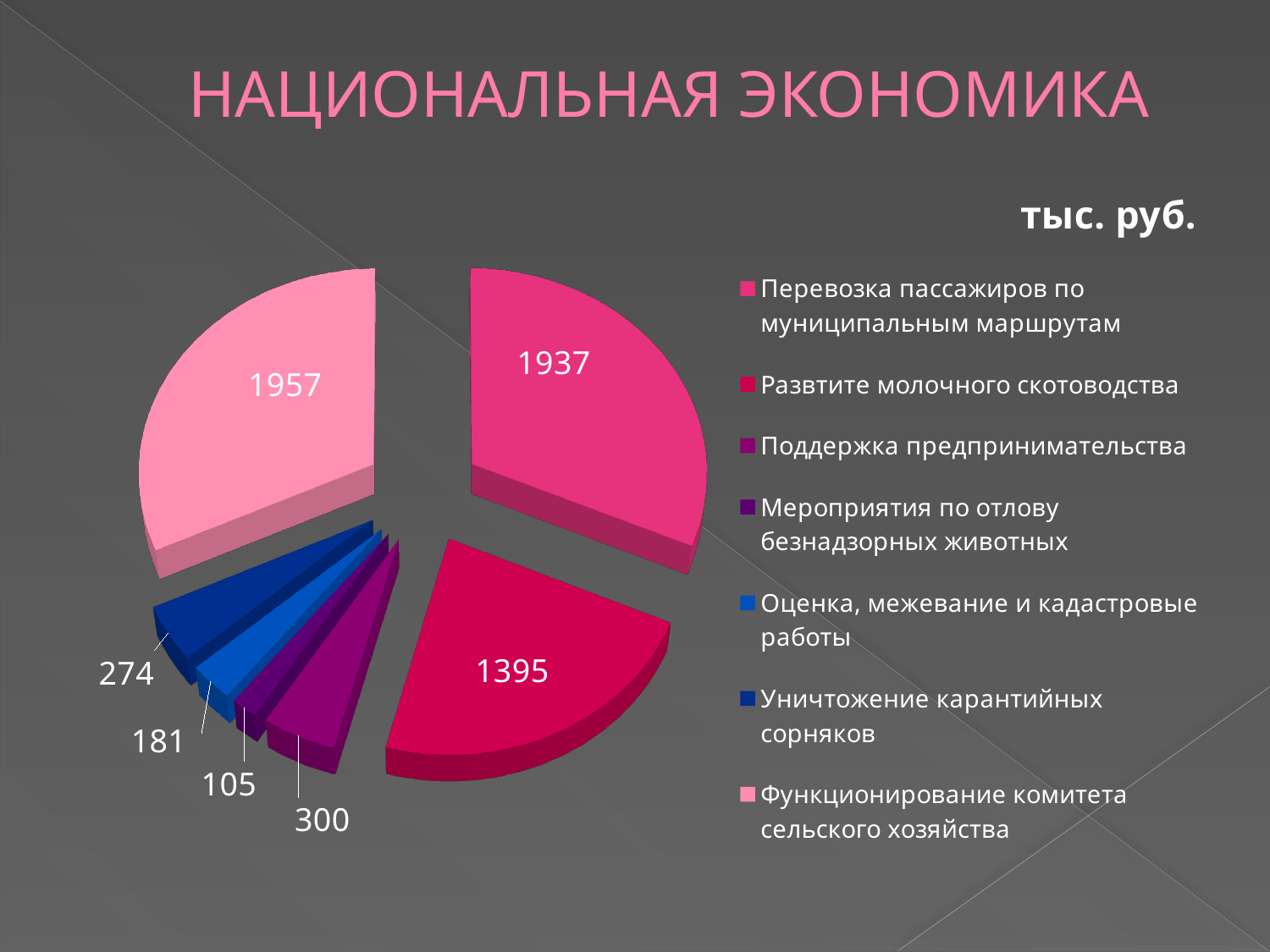
What is the value for Перевозка пассажиров по муниципальным маршрутам? 1937 What is the difference between the values for Функционирование комитета сельского хозяйства and Перевозка пассажиров по муниципальным маршрутам? 20 What unit is indicated above the legend? тыс. руб. How many categories does the legend list? 7 Which is larger: Оценка, межевание и кадастровые работы or Поддержка предпринимательства? Поддержка предпринимательства What is the value for Развтите молочного скотоводства? 1395 Which category has the smallest value? Мероприятия по отлову безнадзорных животных Which category has the largest value? Функционирование комитета сельского хозяйства What is the value for Уничтожение карантийных сорняков? 274 What is the value for Функционирование комитета сельского хозяйства? 1957 What is the value for Мероприятия по отлову безнадзорных животных? 105 What type of chart is shown on the slide? pie chart